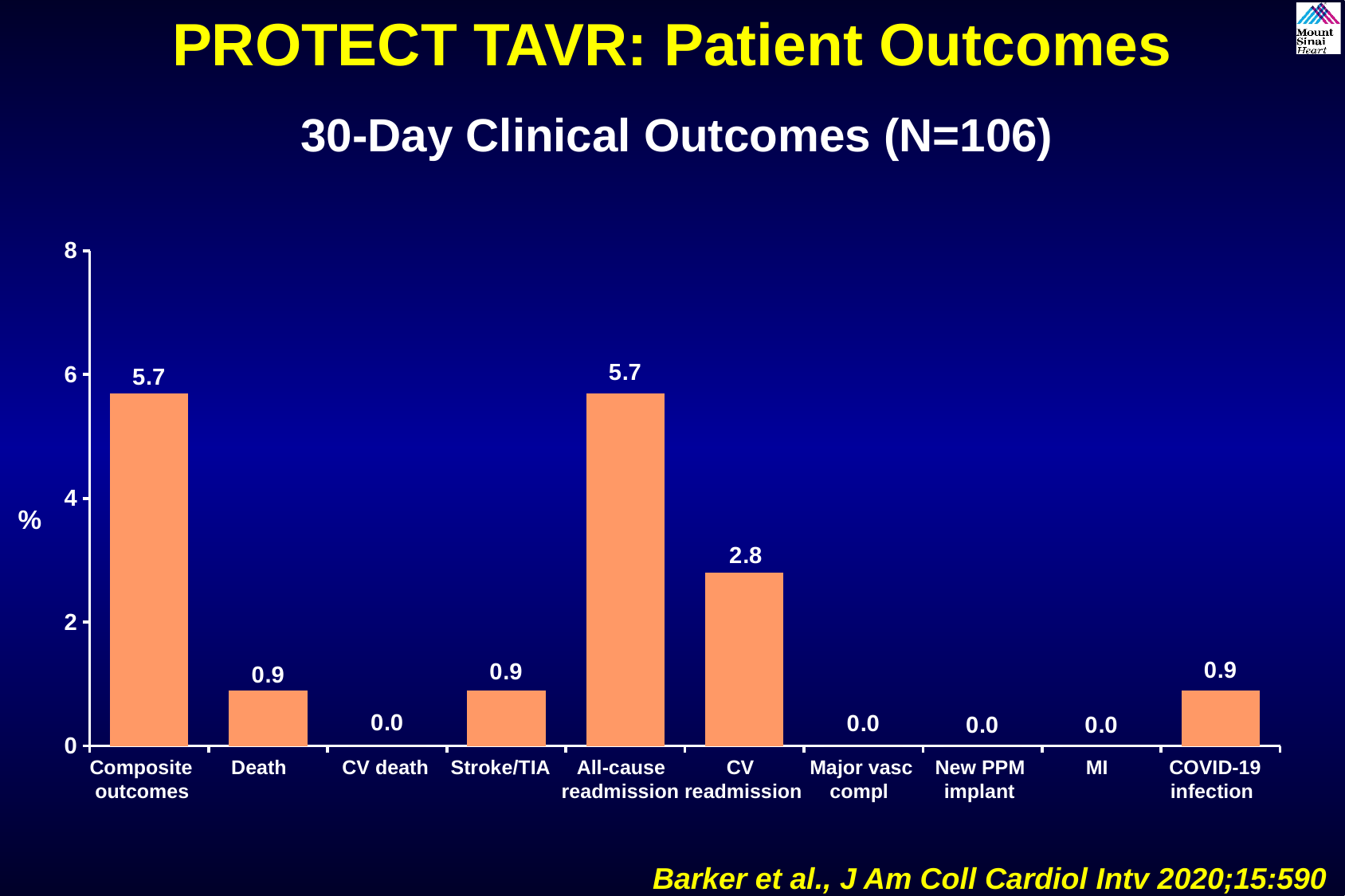
What is the title of the chart? 30-Day Clinical Outcomes (N=106) What kind of chart is shown on the slide? bar chart How many categories are shown on the x axis? 10 What is the value for MI? 0.0 Which is larger, the value for CV readmission or the value for Stroke/TIA? CV readmission What is the difference between the values for All-cause readmission and CV readmission? 2.9 What is the value for CV readmission? 2.8 What is the value for Composite outcomes? 5.7 Is the value for Composite outcomes greater or less than 4? greater What is the value for COVID-19 infection? 0.9 How many categories have a value of 0.0? 4 What is the value for Death? 0.9